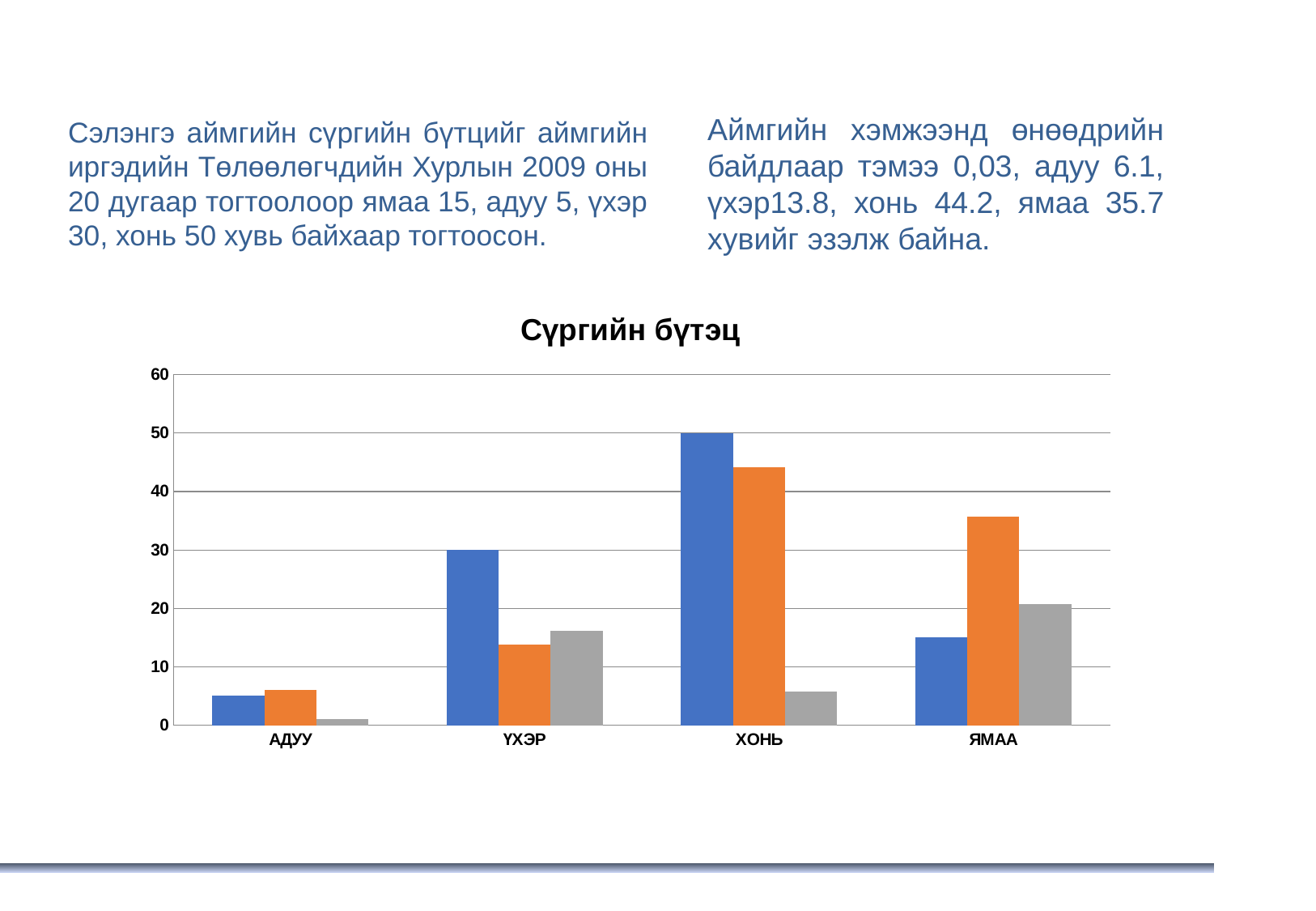
Which category has the lowest gray bar? АДУУ For ХОНЬ, which is larger: the blue bar or the orange bar? the blue bar What is the value of the blue bar for ҮХЭР? 30 How many bars are plotted for each category in the chart? 3 Is the gray bar for ХОНЬ greater or less than 10? less What is the value of the blue bar for ХОНЬ? 50 Is the orange bar for ЯМАА greater or less than 30? greater How many categories are shown on the x axis of the chart? 4 What is the title of the chart? Сүргийн бүтэц What kind of chart is shown on the slide? bar chart Which category has the tallest blue bar? ХОНЬ For ЯМАА, which is larger: the blue bar or the orange bar? the orange bar